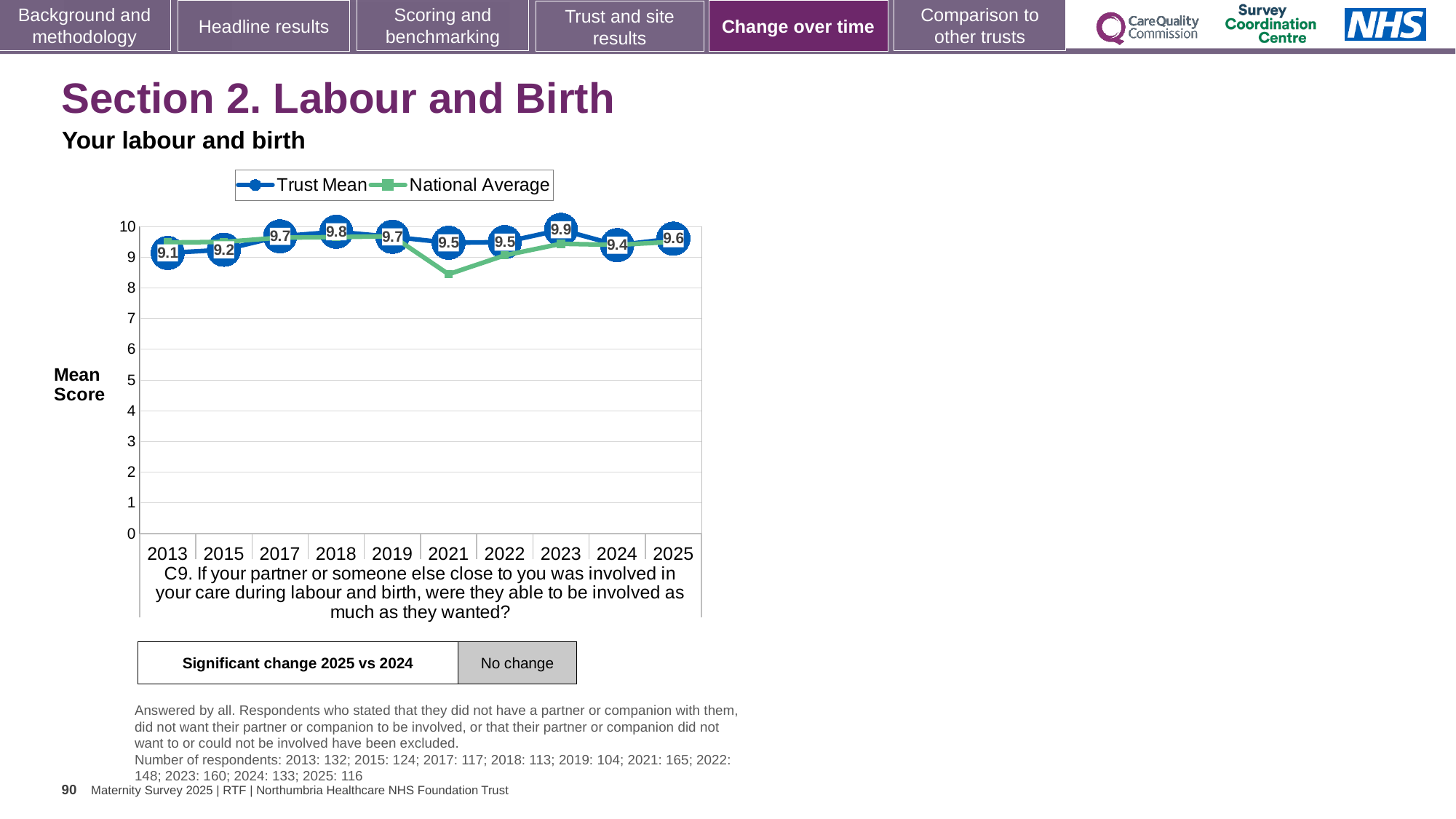
How many years are shown on the x axis? 10 What is the difference between the Trust Mean in 2023 and in 2013? 0.8 Is the National Average value for 2021 greater or less than 9? less In which year is the Trust Mean highest? 2023 Which is larger, the Trust Mean for 2018 or for 2024? 2018 What is the Trust Mean for 2025? 9.6 What kind of chart is shown on the slide? line chart What is the Trust Mean for 2021? 9.5 How many series does the legend list? 2 What is the Trust Mean for 2013? 9.1 In which year is the Trust Mean lowest? 2013 Does the Trust Mean rise or fall from 2013 to 2018? rise